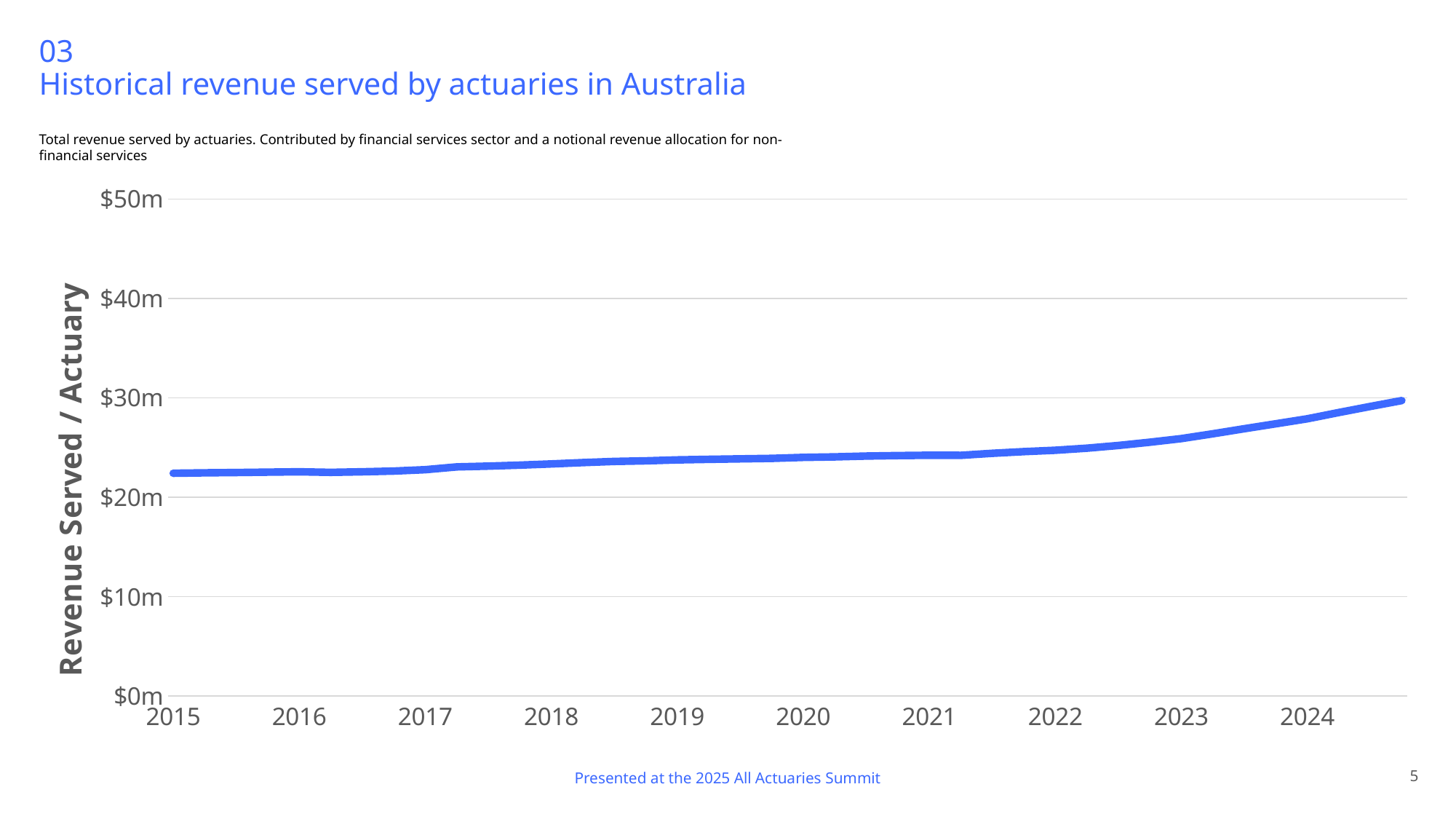
What is the label on the vertical axis of the chart? Revenue Served / Actuary Which is larger, the value for 2023 or the value for 2018? 2023 Is the value for 2020 greater or less than $30m? less How many years are labelled on the horizontal axis? 10 Which labelled year has the highest revenue served per actuary? 2024 Is the value for 2015 greater or less than $20m? greater Is the value for 2023 greater or less than $20m? greater What kind of chart is shown on the slide? line chart What is the title of the chart on the slide? Historical revenue served by actuaries in Australia Does the revenue served per actuary rise or fall from 2015 to 2024? rise